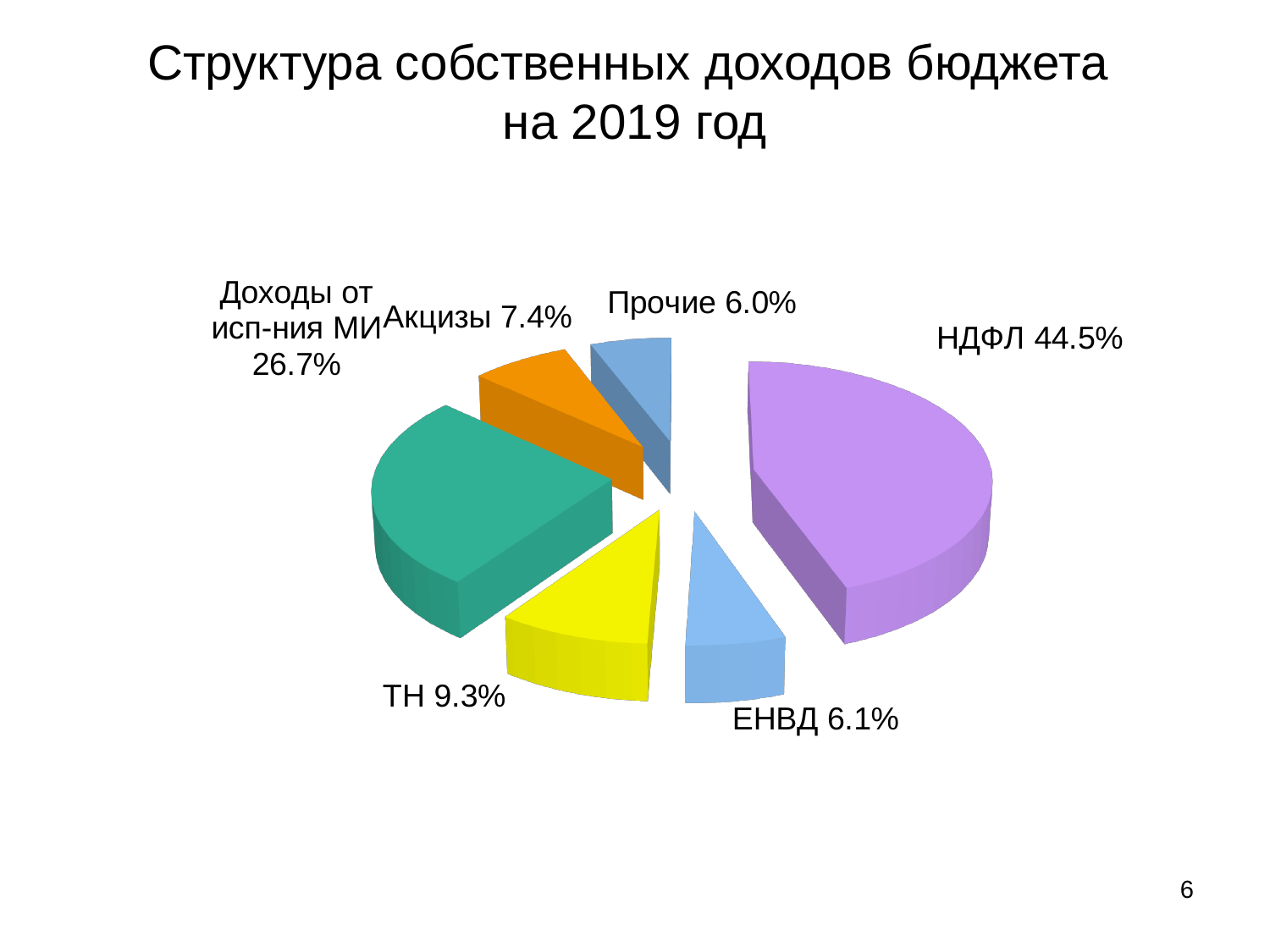
Which category has the smallest slice of the pie? Прочие What is the title of the chart on the slide? Структура собственных доходов бюджета на 2019 год How many slices does the pie chart have? 6 What is the value shown for Доходы от исп-ния МИ? 26.7% What is the difference between the shares of НДФЛ and Доходы от исп-ния МИ? 17.8% What percentage is shown for ЕНВД? 6.1% What is the value for ТН? 9.3% What share of the pie does НДФЛ account for? 44.5% Which is larger, the share of ТН or the share of Акцизы? ТН What type of chart is shown on the slide? Pie chart Which category has the largest slice of the pie? НДФЛ What percentage is shown for Акцизы? 7.4%